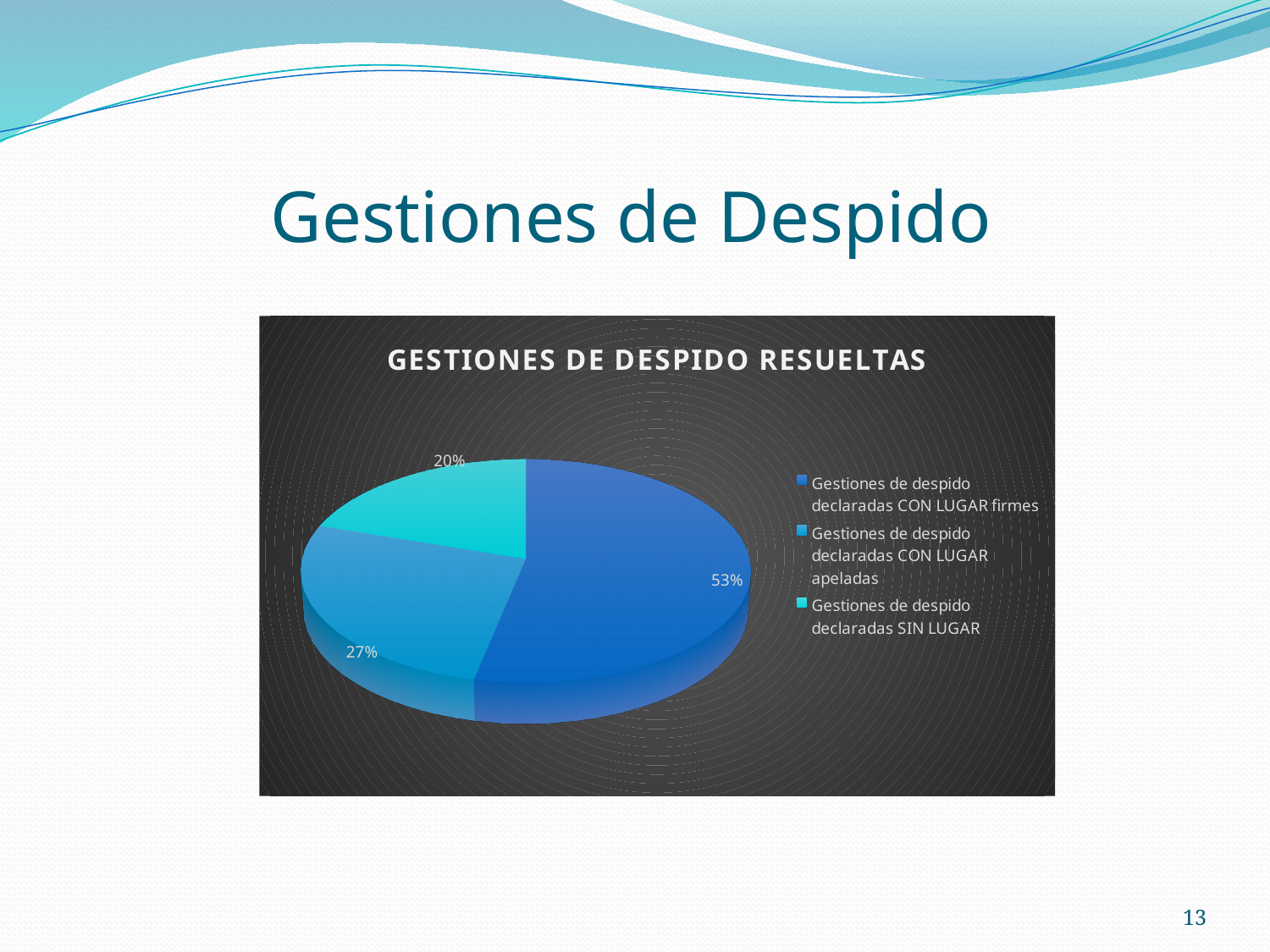
Which category has the smallest slice of the pie? Gestiones de despido declaradas SIN LUGAR How many categories does the pie chart have? 3 How many entries does the legend list? 3 What share of the pie is 'Gestiones de despido declaradas CON LUGAR firmes'? 53% What is the difference in percentage points between the 'CON LUGAR firmes' slice and the 'CON LUGAR apeladas' slice? 26% What is the difference in percentage points between the 'CON LUGAR apeladas' slice and the 'SIN LUGAR' slice? 7% Which is larger: the 'CON LUGAR apeladas' slice or the 'SIN LUGAR' slice? CON LUGAR apeladas Which category has the largest slice of the pie? Gestiones de despido declaradas CON LUGAR firmes What share of the pie is 'Gestiones de despido declaradas CON LUGAR apeladas'? 27% What type of chart is shown on the slide? Pie chart What share of the pie is 'Gestiones de despido declaradas SIN LUGAR'? 20% What is the title of the chart? GESTIONES DE DESPIDO RESUELTAS